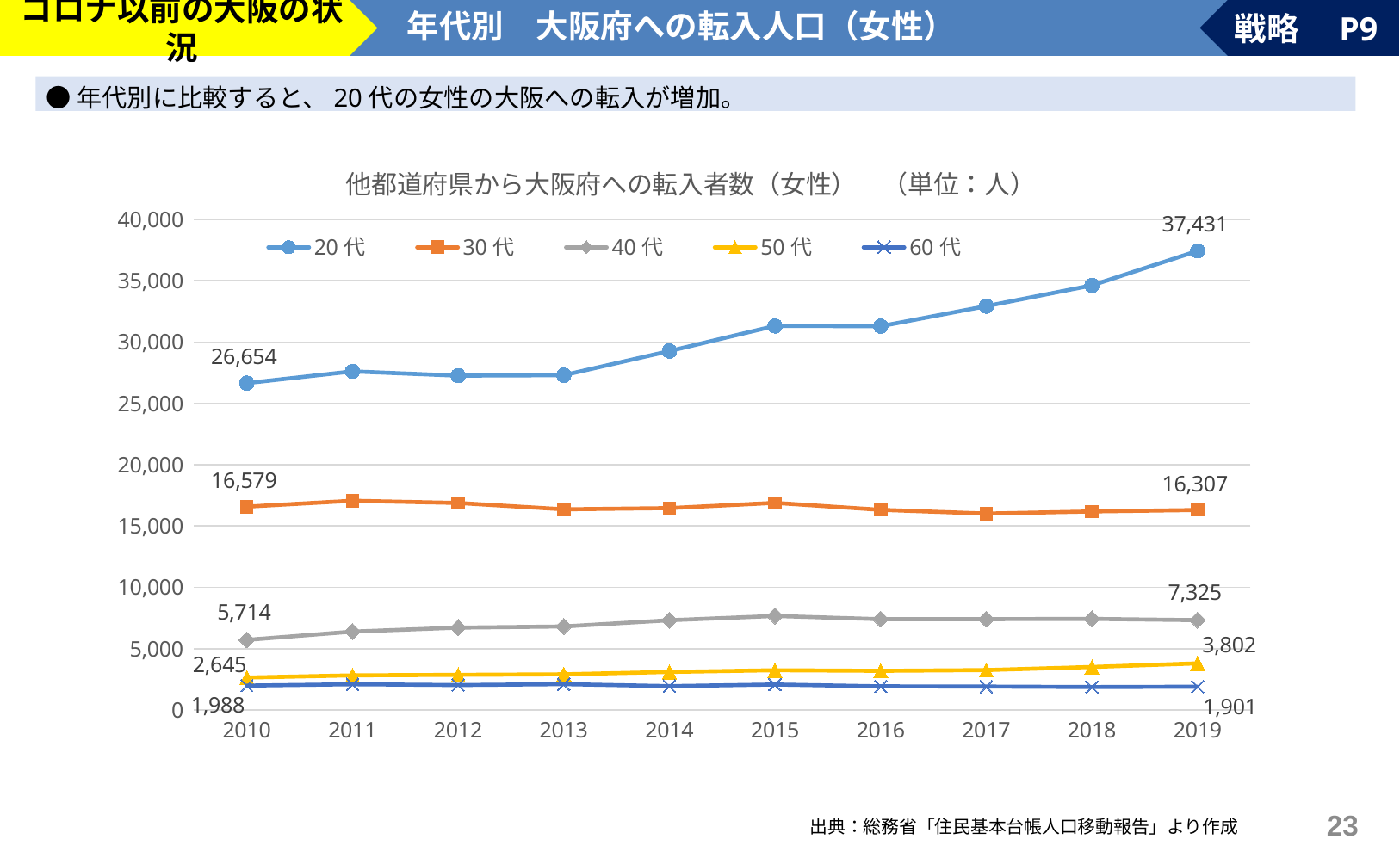
What is the value for 20代 in 2019? 37,431 What type of chart is shown on the slide? line chart Is the value for 50代 in 2019 larger or smaller than the value for 50代 in 2010? larger What is the value for 40代 in 2019? 7,325 What is the difference between the 20代 values in 2019 and 2010? 10,777 Is the value for 20代 in 2015 greater or less than 30,000? greater How many series does the legend list? 5 What is the value for 30代 in 2010? 16,579 Which series has the highest value in 2019? 20代 How many years are shown on the x axis? 10 Which series has the lowest value in 2010? 60代 What is the value for 60代 in 2010? 1,988